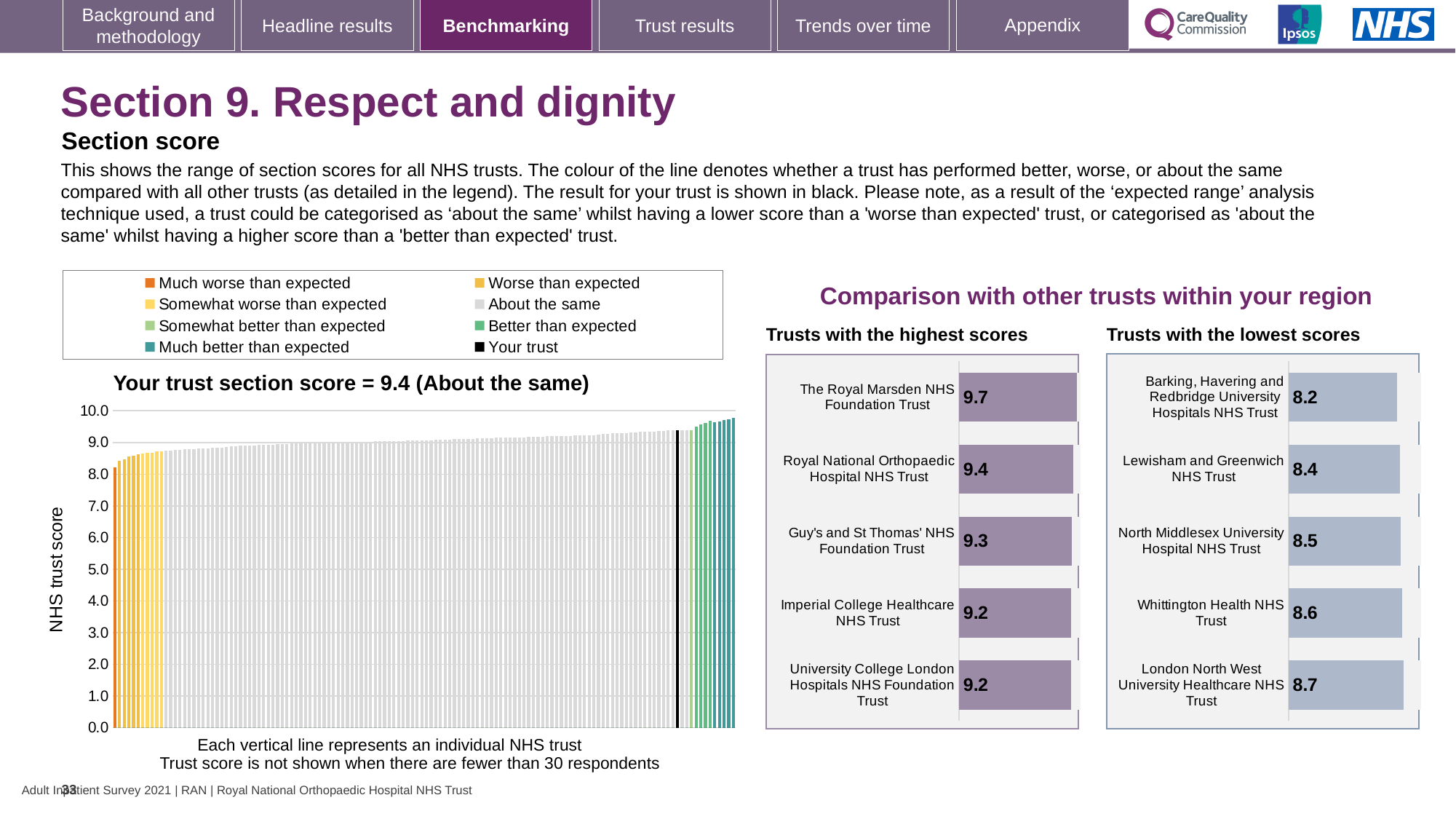
In the 'Trusts with the lowest scores' chart, what is the score for Lewisham and Greenwich NHS Trust? 8.4 In the 'Trusts with the highest scores' chart, what is the score for The Royal Marsden NHS Foundation Trust? 9.7 In the 'Trusts with the lowest scores' chart, which has the larger score: Whittington Health NHS Trust or North Middlesex University Hospital NHS Trust? Whittington Health NHS Trust In the large chart on the left, what is the section score for your trust, as stated in the chart title? 9.4 In the 'Trusts with the lowest scores' chart, which trust has the lowest score? Barking, Havering and Redbridge University Hospitals NHS Trust In the 'Trusts with the highest scores' chart, which trust has the highest score? The Royal Marsden NHS Foundation Trust In the large chart on the left, what is the label on the vertical axis? NHS trust score In the large chart on the left, do the bar values rise or fall from left to right along the x axis? rise In the large chart on the left, is the value of the tallest bar greater or less than 10.0? less What kind of chart is the large chart titled 'Your trust section score = 9.4 (About the same)'? bar chart In the 'Trusts with the highest scores' chart, how many trusts are shown? 5 In the 'Trusts with the highest scores' chart, what is the difference between the scores of The Royal Marsden NHS Foundation Trust and Guy's and St Thomas' NHS Foundation Trust? 0.4